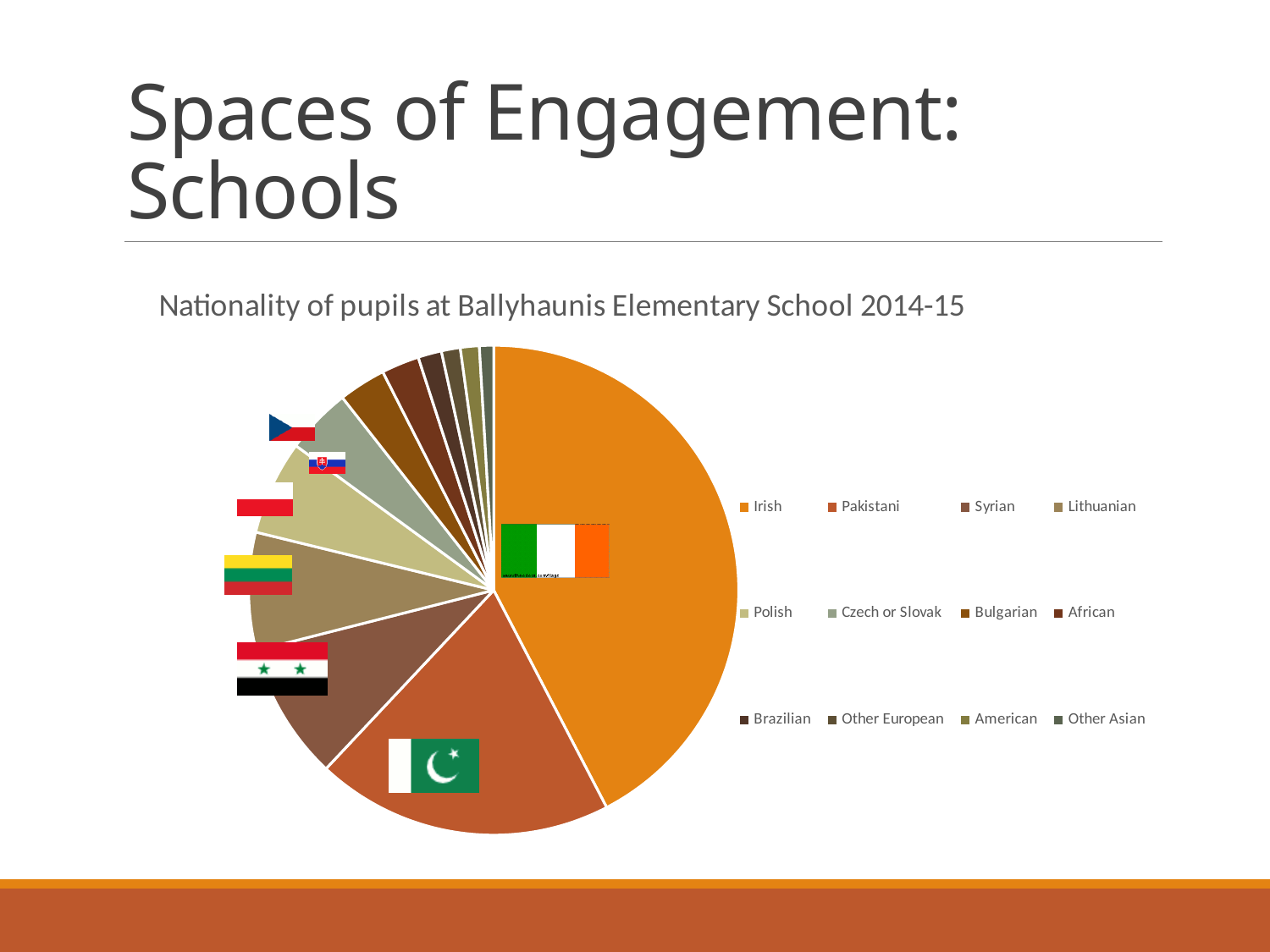
What kind of chart is shown on the slide? Pie chart How many nationality categories does the pie chart show? 12 Which slice is larger, Syrian or American? Syrian Which slice is larger, Pakistani or Syrian? Pakistani Which nationality has the largest slice of the pie chart? Irish What is the title of the chart? Nationality of pupils at Ballyhaunis Elementary School 2014-15 Which nationality has the second-largest slice of the pie chart? Pakistani Which legend entry is listed first in the chart's legend? Irish Which slice is larger, Irish or Pakistani? Irish